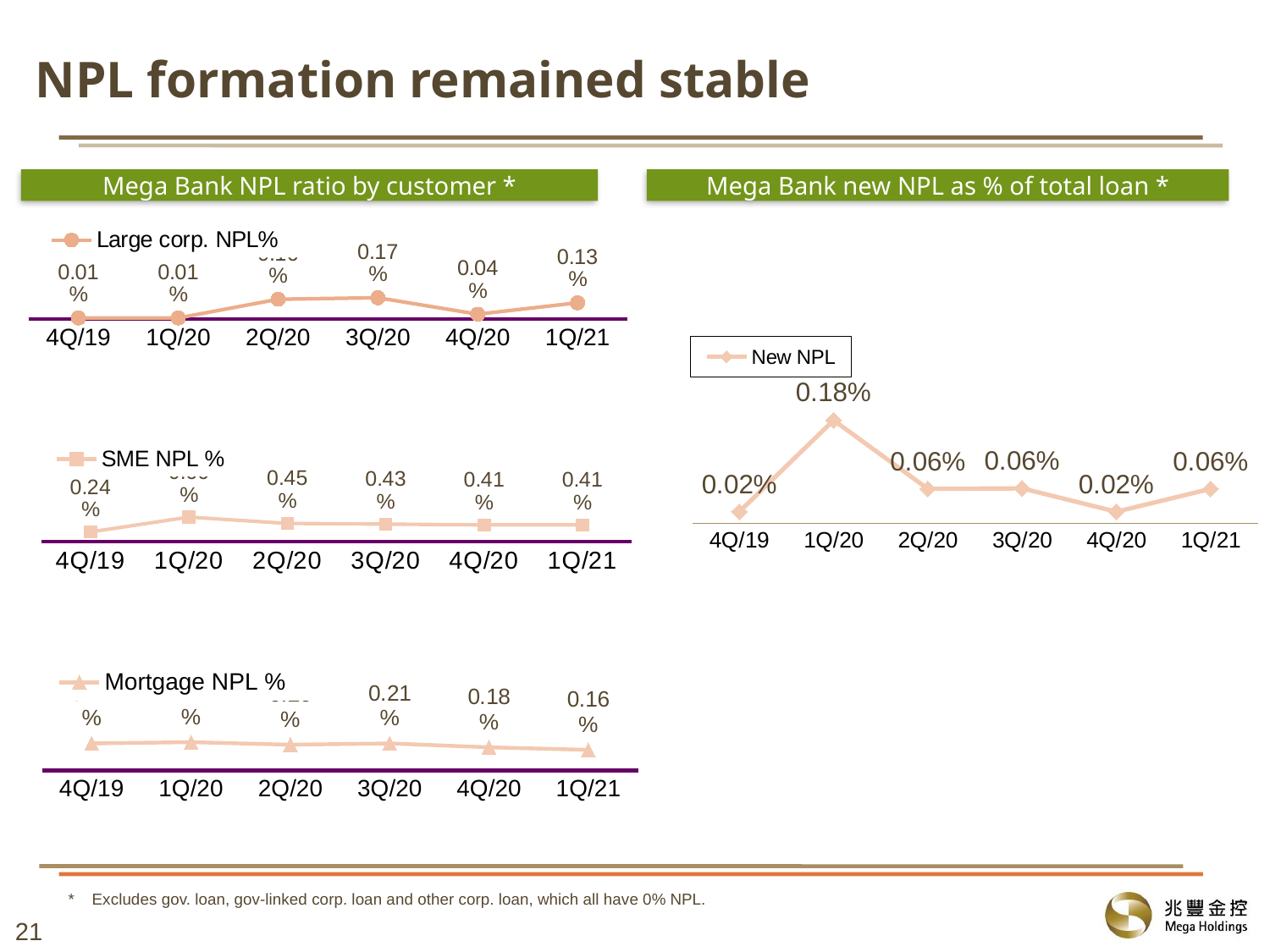
In the Mortgage NPL % chart, what is the value for 4Q/20? 0.18% In the SME NPL % chart, what is the value for 4Q/19? 0.24% In the SME NPL % chart, what is the value for 2Q/20? 0.45% In the Mega Bank new NPL as % of total loan chart, what is the value for 1Q/20? 0.18% In the SME NPL % chart, which is larger, the value for 2Q/20 or the value for 3Q/20? 2Q/20 In the Large corp. NPL% chart, what is the value for 3Q/20? 0.17% In the Mega Bank new NPL as % of total loan chart, what is the difference between the 1Q/20 and 2Q/20 values? 0.12% In the Mega Bank new NPL as % of total loan chart, which quarter has the highest value? 1Q/20 What kind of chart is the Mega Bank new NPL as % of total loan chart? Line chart In the Large corp. NPL% chart, what is the value for 1Q/21? 0.13% How many quarters are plotted in the Mega Bank new NPL as % of total loan chart? 6 In the Mortgage NPL % chart, do the values rise or fall from 3Q/20 to 1Q/21? Fall